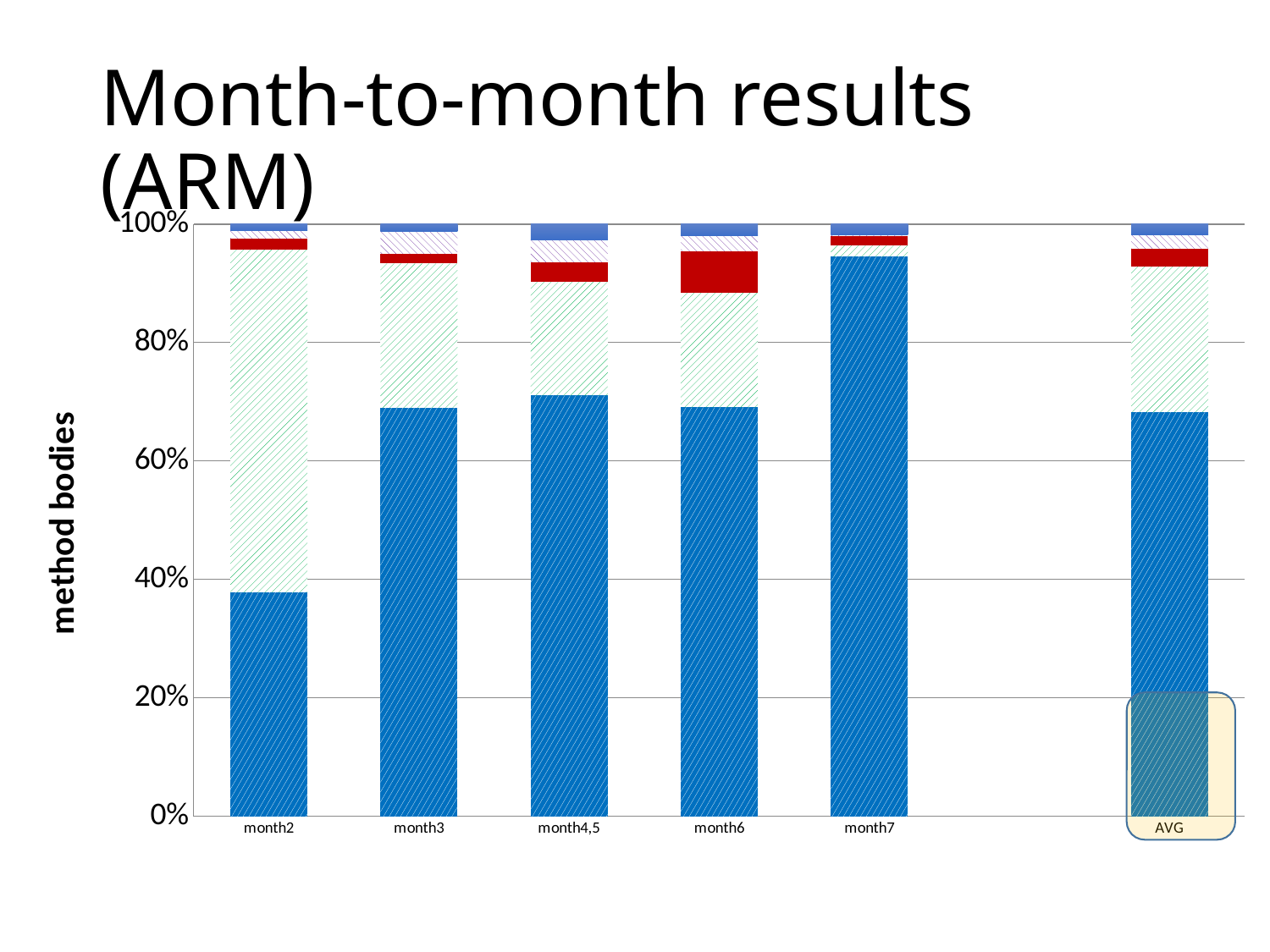
Which category has the smallest bottom (solid blue) segment? month2 What is the label on the vertical axis of the chart? method bodies What is the total height of the stacked bar for month2? 100% Is the bottom blue segment for month2 greater or less than 40%? less What kind of chart is shown on the slide? stacked bar chart Is the bottom blue segment for AVG greater or less than 60%? greater Which has a larger bottom blue segment, month2 or month3? month3 Is the bottom blue segment for month3 greater or less than 60%? greater What is the title of the chart slide? Month-to-month results (ARM) How many categories are shown on the x axis of the chart? 6 Which category has the largest bottom (solid blue) segment? month7